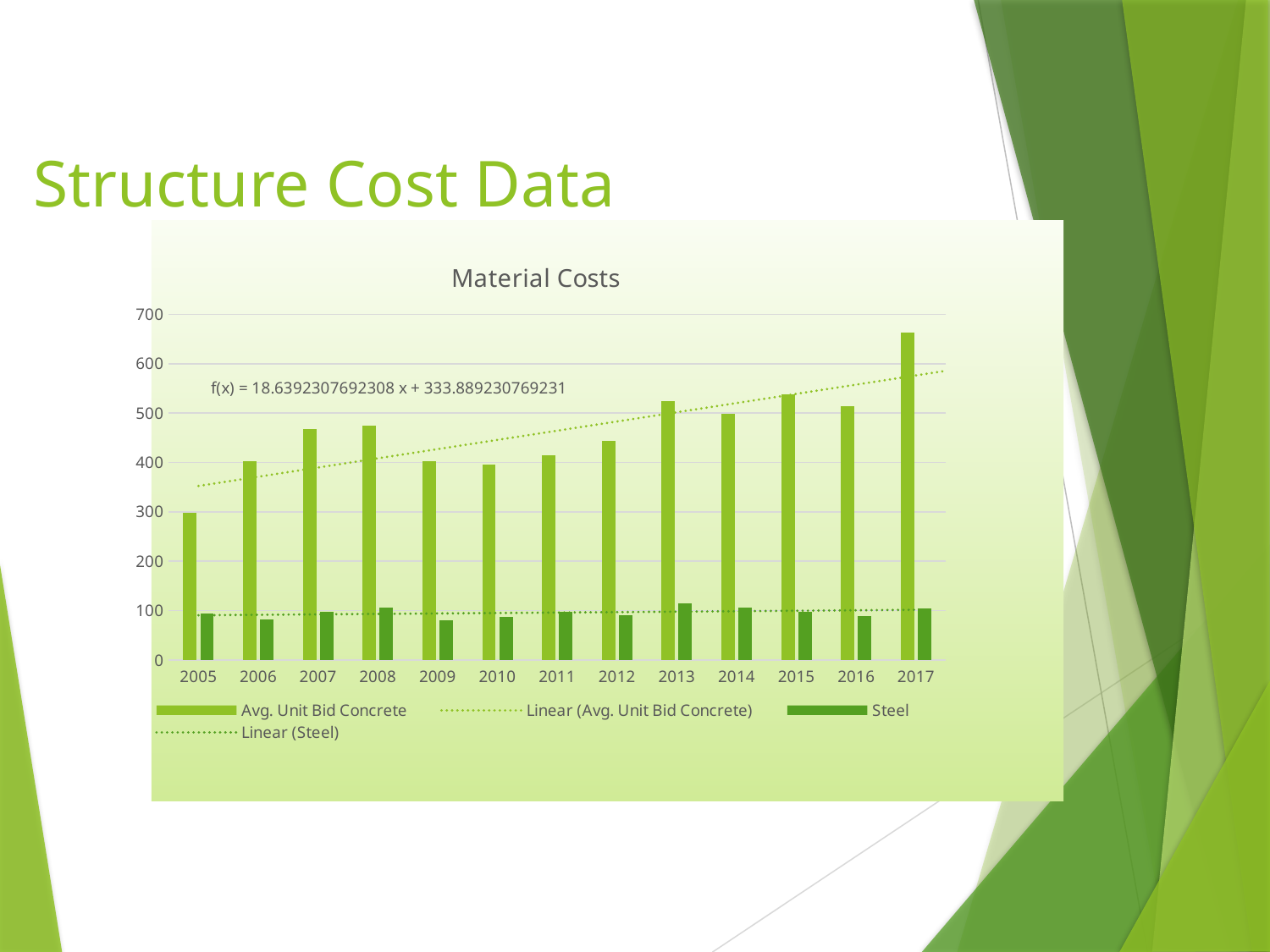
Which year has the highest Avg. Unit Bid Concrete value? 2017 Which year has the lowest Avg. Unit Bid Concrete value? 2005 What type of chart is shown on the slide? Bar chart Is the Steel value for 2006 greater or less than 100? less Is the Avg. Unit Bid Concrete value for 2005 greater or less than 400? less How many years are shown on the x axis of the chart? 13 Do the Avg. Unit Bid Concrete values generally rise or fall from 2005 to 2017? rise What trendline equation is printed on the chart? f(x) = 18.6392307692308 x + 333.889230769231 What is the title of the chart? Material Costs Which year has the larger Avg. Unit Bid Concrete value, 2012 or 2013? 2013 How many entries does the chart's legend list? 4 Is the Avg. Unit Bid Concrete value for 2017 greater or less than 600? greater